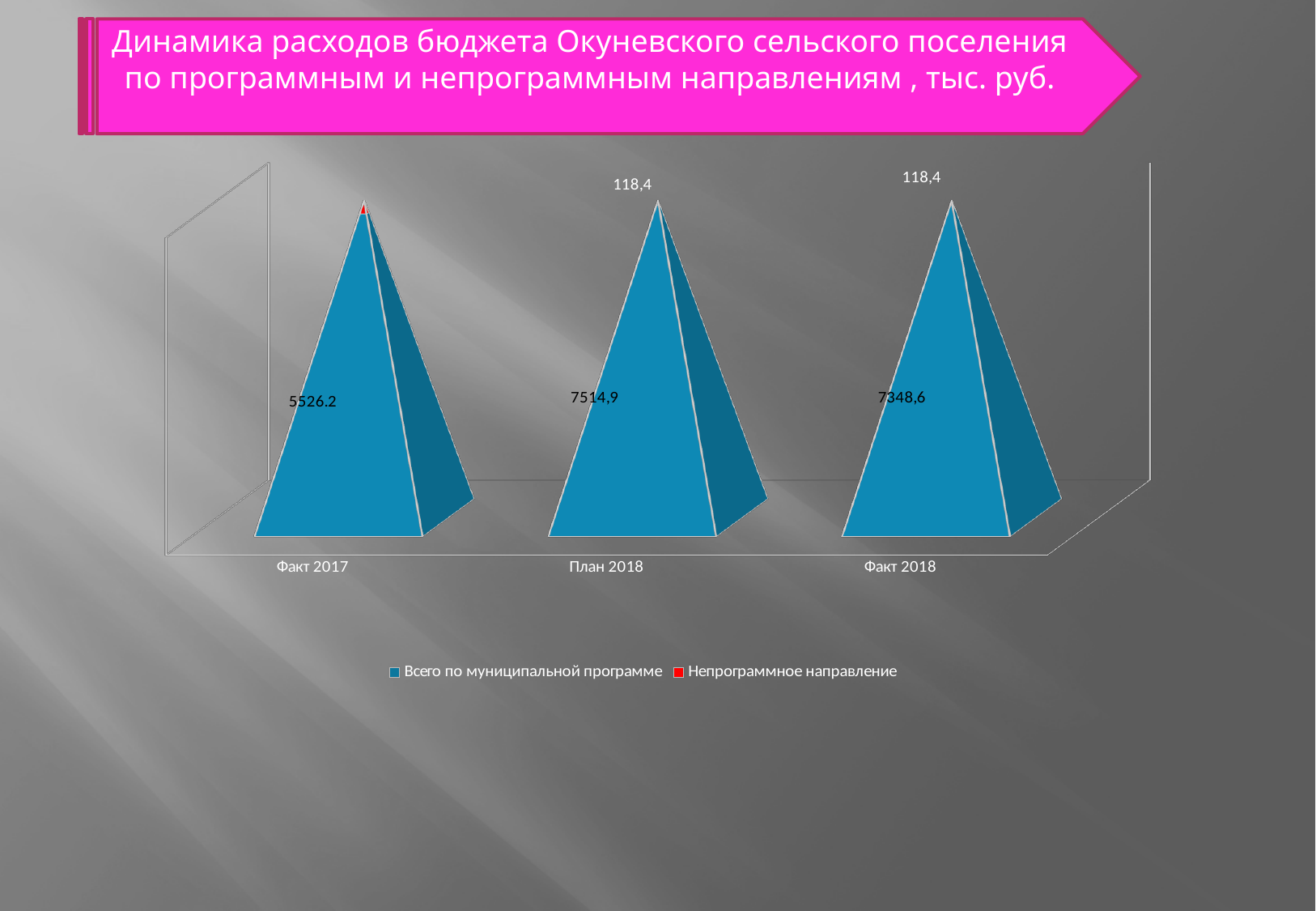
Which category has the highest value for Всего по муниципальной программе? План 2018 What is the value for Всего по муниципальной программе for План 2018? 7514,9 What colour represents Непрограммное направление in the legend? Red What is the total of the stacked bar for План 2018? 7633,3 What is the value for Всего по муниципальной программе for Факт 2018? 7348,6 How many series does the legend list? 2 How many categories are shown on the x axis? 3 What is the value for Непрограммное направление for План 2018? 118,4 What is the value for Всего по муниципальной программе for Факт 2017? 5526.2 Which category has the lowest value for Всего по муниципальной программе? Факт 2017 What is the difference between the Всего по муниципальной программе values for План 2018 and Факт 2018? 166,3 Which is larger for Всего по муниципальной программе: Факт 2017 or Факт 2018? Факт 2018